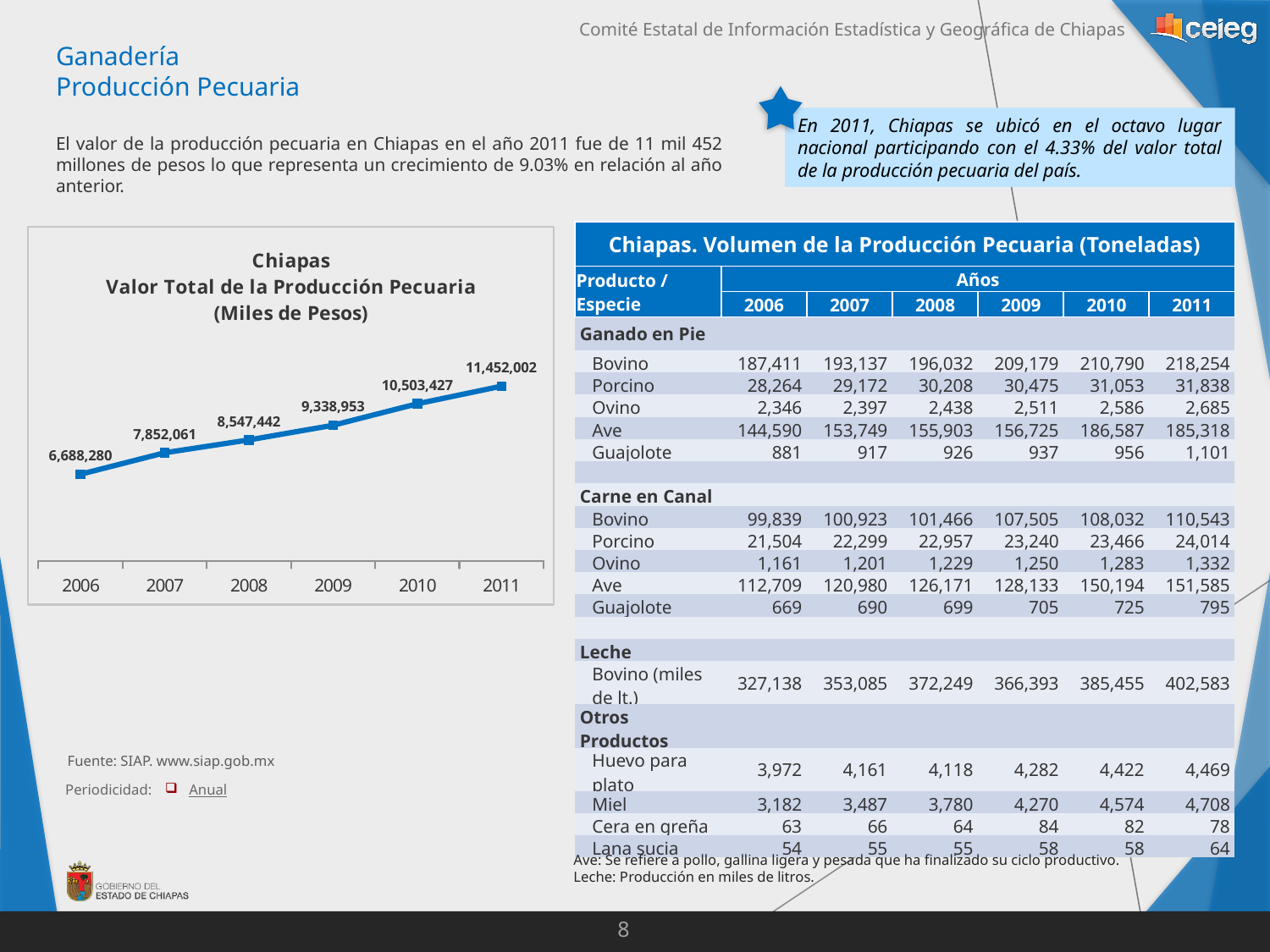
Which year has the lowest value in the chart? 2006 Which year has a larger value in the chart, 2007 or 2008? 2008 What type of chart is shown on the slide? Line chart What is the value plotted for 2008? 8,547,442 Do the values in the chart rise or fall from 2006 to 2011? Rise What is the difference between the 2011 value and the 2010 value in the chart? 948,575 In what unit are the values in the chart expressed, according to its title? Miles de Pesos How many years are plotted in the chart? 6 What value does the chart show for 2009? 9,338,953 Which year has the highest value in the chart? 2011 What is the value of the total livestock production in 2006 according to the chart? 6,688,280 What is the value shown for 2011 in the chart? 11,452,002